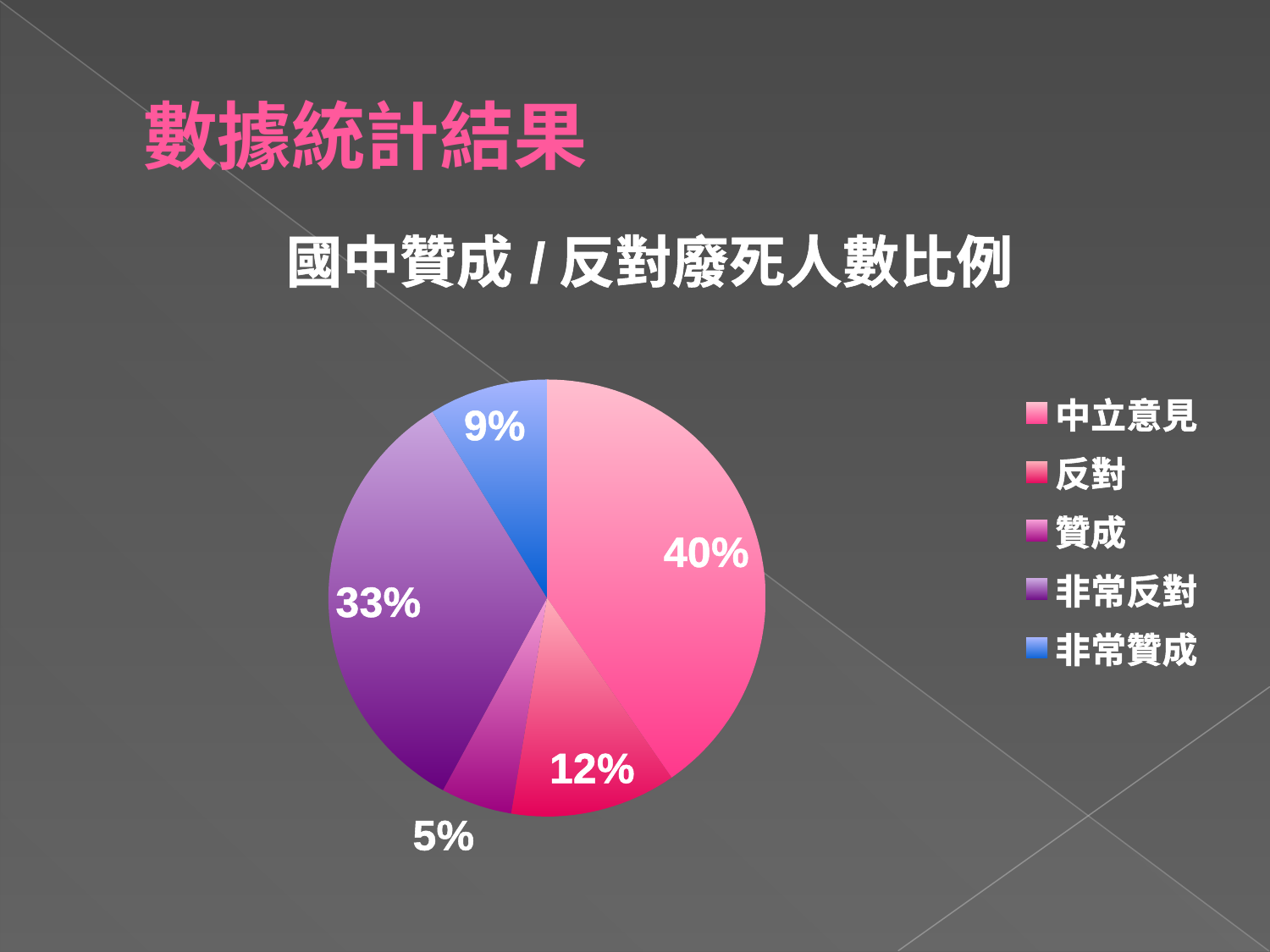
Which is larger, the share for 反對 or the share for 贊成? 反對 How many categories does the legend list? 5 What percentage of the pie is labelled 中立意見? 40% Which category has the largest share of the pie? 中立意見 What kind of chart is shown on the slide? Pie chart What percentage of the pie is labelled 贊成? 5% Which category has the smallest share of the pie? 贊成 What percentage of the pie is labelled 非常反對? 33% What is the difference in percentage points between 非常反對 and 非常贊成? 24 What is the title of the chart? 國中贊成 / 反對廢死人數比例 What percentage of the pie is labelled 反對? 12% What percentage of the pie is labelled 非常贊成? 9%